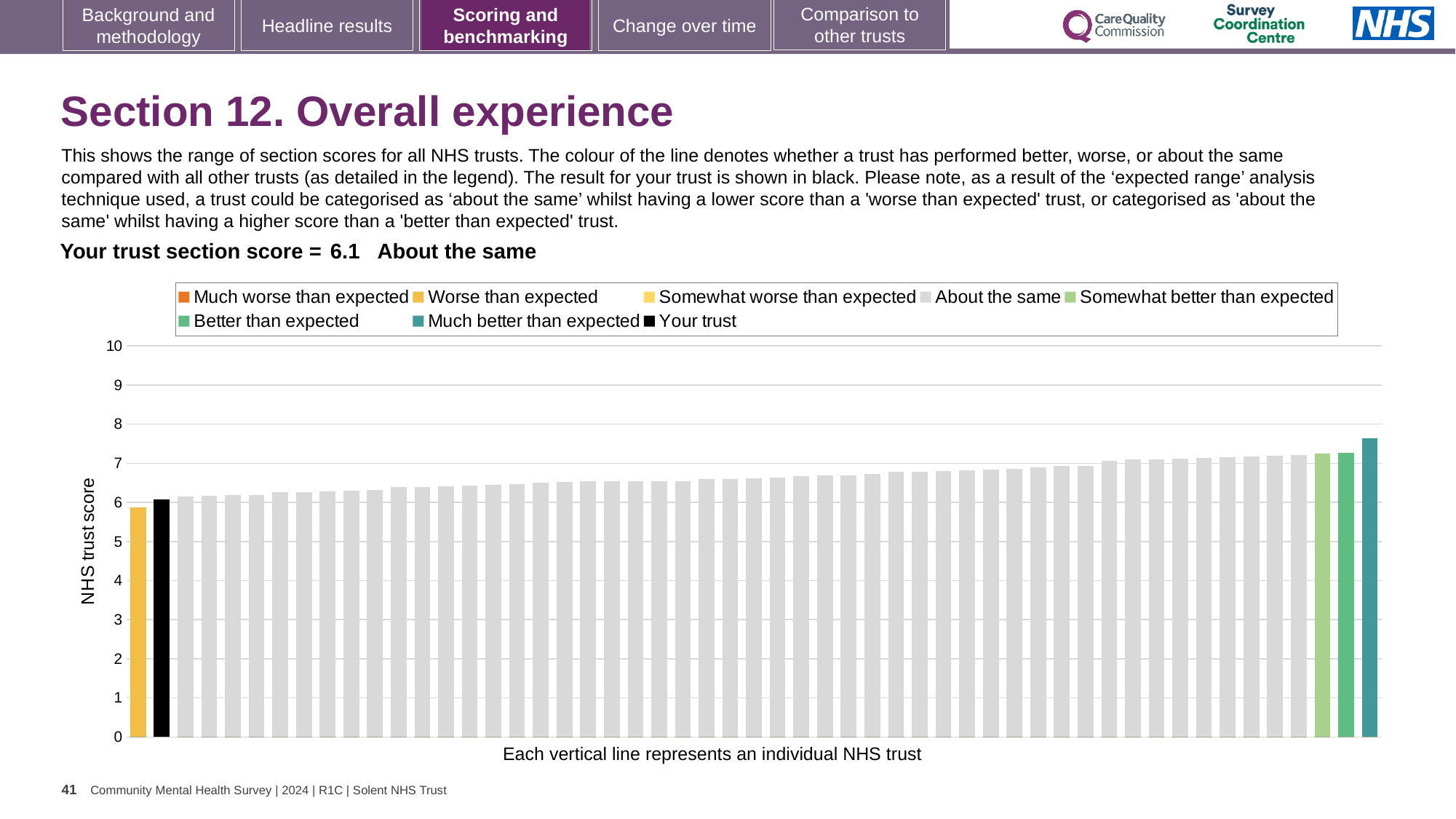
Which benchmarking category is your trust placed in for Section 12? About the same What is the section score for your trust shown on the slide? 6.1 Which legend category does the shortest bar on the chart belong to? Worse than expected What colour is used for the 'Your trust' bar in the chart? black What kind of chart is shown on the slide? bar chart Do the bar values rise or fall from left to right along the x axis? rise Is the value for your trust (the black bar) greater or less than 7? less Which legend category does the tallest bar on the chart belong to? Much better than expected How many entries does the chart legend list? 8 What is the label on the vertical axis of the chart? NHS trust score Is the value of the tallest bar (the teal 'Much better than expected' bar) greater or less than 7? greater Which is taller: the black 'Your trust' bar or the teal 'Much better than expected' bar? the teal 'Much better than expected' bar